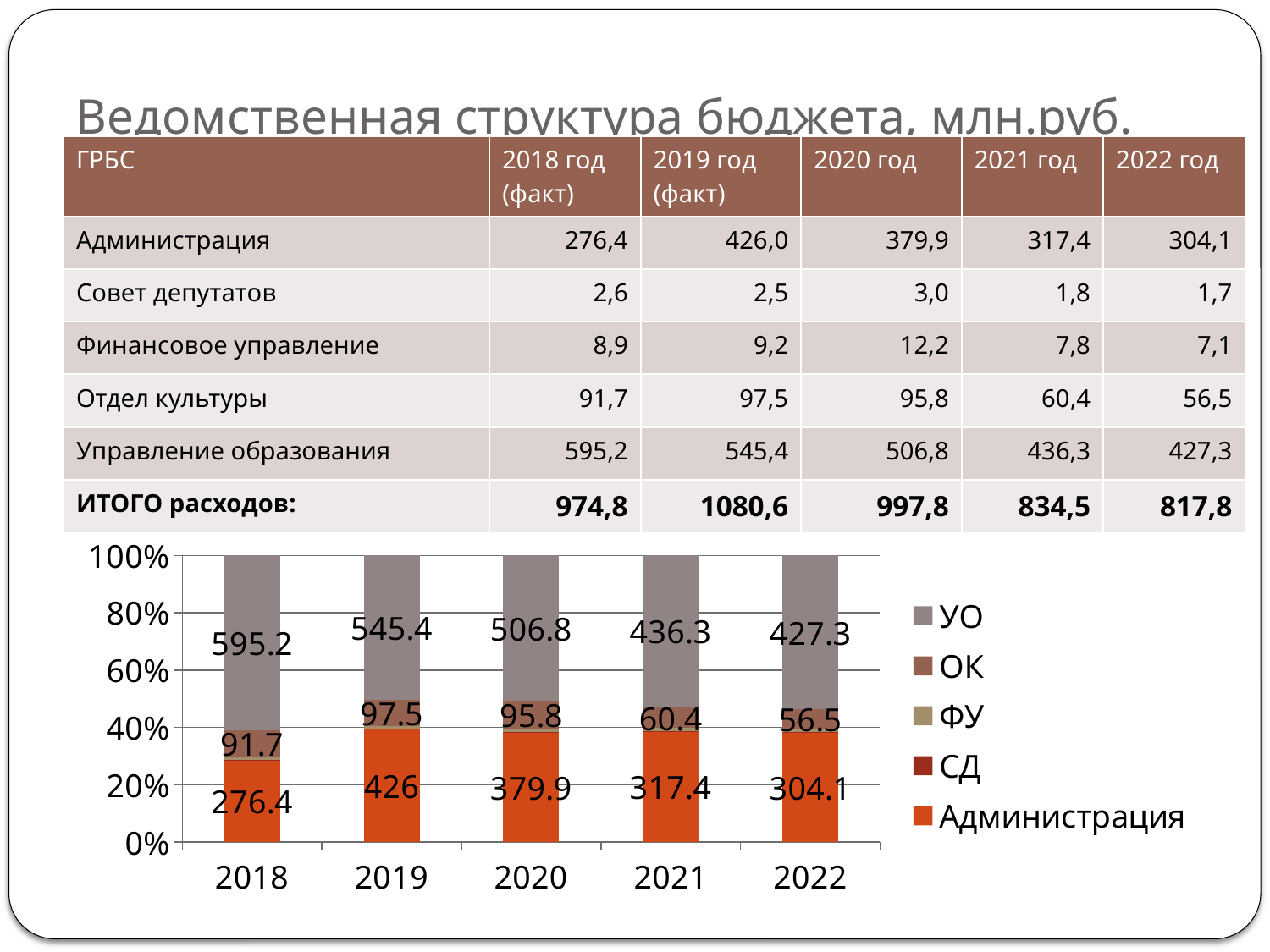
What kind of chart is shown below the table? 100% stacked bar chart How many series does the chart legend list? 5 In which year is the УО value on the chart highest? 2018 How many years (categories) are shown on the x axis of the chart? 5 What is the difference between the УО values for 2018 and 2022 on the chart? 167.9 Which is larger on the chart: the Администрация value for 2020 or for 2021? 2020 Is the top of the Администрация segment for 2018 above or below the 40% line on the chart? below What is the value labelled for Администрация in 2019 on the chart? 426 What is the value labelled for УО in 2018 on the chart? 595.2 Do the УО values on the chart rise or fall from 2018 to 2022? fall In which year is the ОК value on the chart lowest? 2022 What is the value labelled for ОК in 2021 on the chart? 60.4